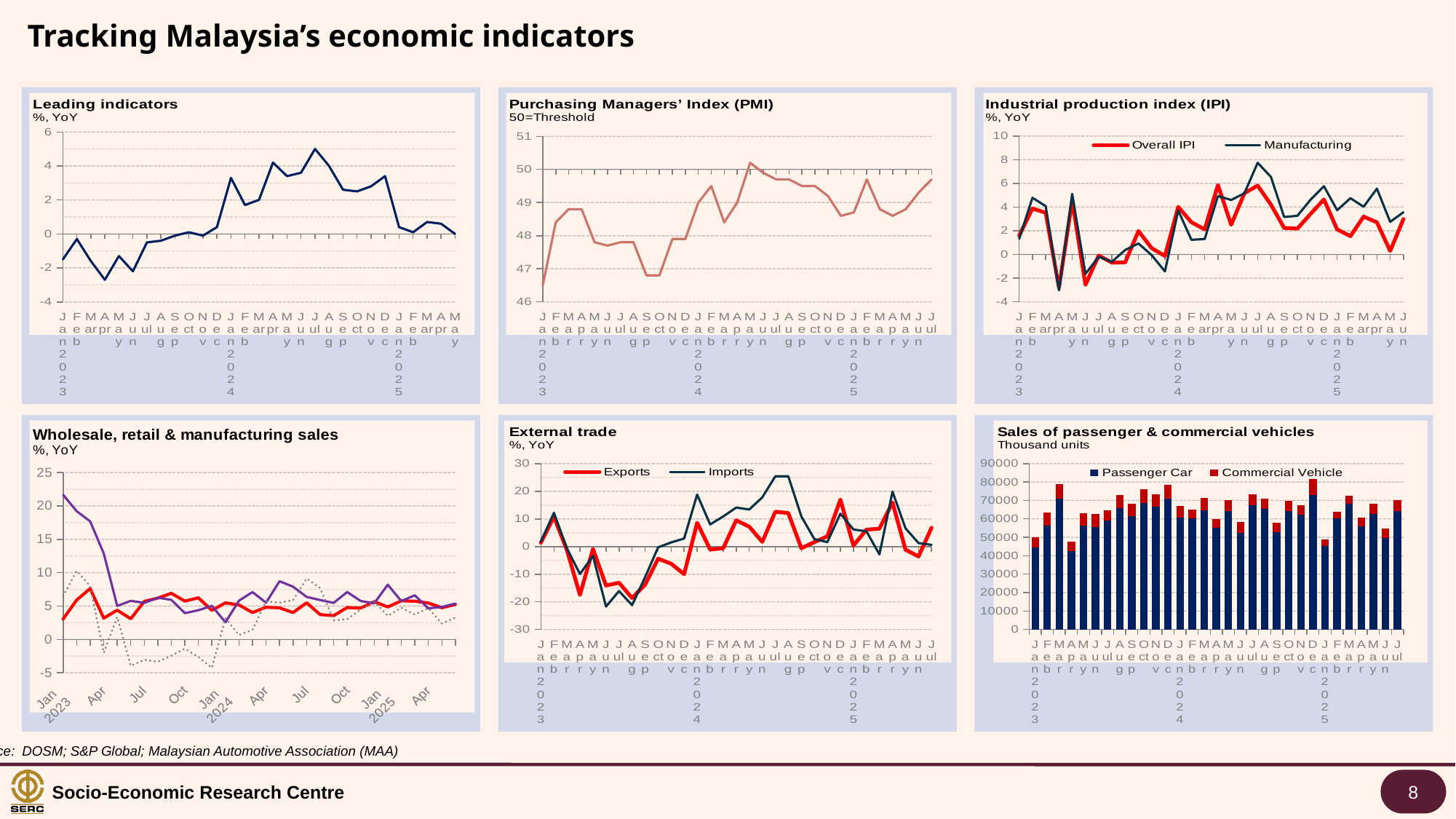
How many series does the legend of the 'External trade' chart list? 2 In the 'Sales of passenger & commercial vehicles' chart, what are the two series named in the legend? Passenger Car and Commercial Vehicle What kind of chart is the 'Sales of passenger & commercial vehicles' chart? bar chart How many charts are shown on the slide? 6 In the 'Purchasing Managers' Index (PMI)' chart, is the value for Jan 2023 greater or less than 47? less In the 'Leading indicators' chart, is the lowest value on the line greater or less than -2? less In the 'Sales of passenger & commercial vehicles' chart, is the total of the tallest bar greater or less than 70000? greater In the 'Purchasing Managers' Index (PMI)' chart, does the line overall rise or fall from Jan 2023 to the last point shown? rise How many series does the legend of the 'Industrial production index (IPI)' chart list? 2 What kind of chart is the 'Leading indicators' chart? line chart